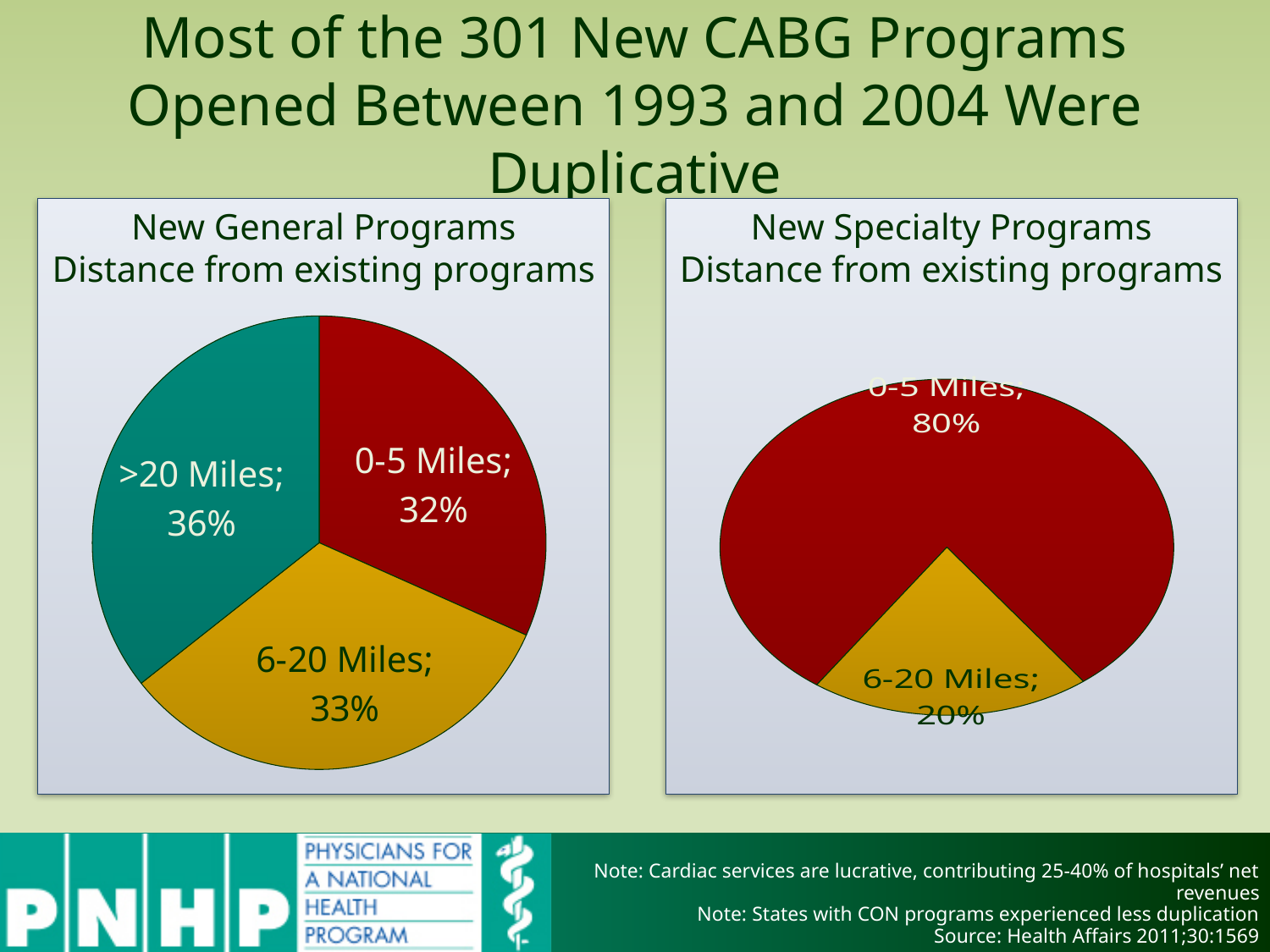
What type of chart is used for the New Specialty Programs chart? Pie chart In the New Specialty Programs chart, what share of programs were 6-20 Miles from existing programs? 20% In the New Specialty Programs chart, what share of programs were 0-5 Miles from existing programs? 80% In the New General Programs chart, what share of programs were 6-20 Miles from existing programs? 33% In the New Specialty Programs chart, what is the difference in percentage points between the 0-5 Miles and 6-20 Miles slices? 60 How many slices does the New General Programs pie chart have? 3 How many slices does the New Specialty Programs pie chart have? 2 In the New General Programs chart, what share of programs were >20 Miles from existing programs? 36% In the New Specialty Programs chart, which distance category has the largest share? 0-5 Miles In the New General Programs chart, which distance category has the smallest share? 0-5 Miles In the New General Programs chart, what share of programs were 0-5 Miles from existing programs? 32% In the New General Programs chart, which distance category has the largest share? >20 Miles